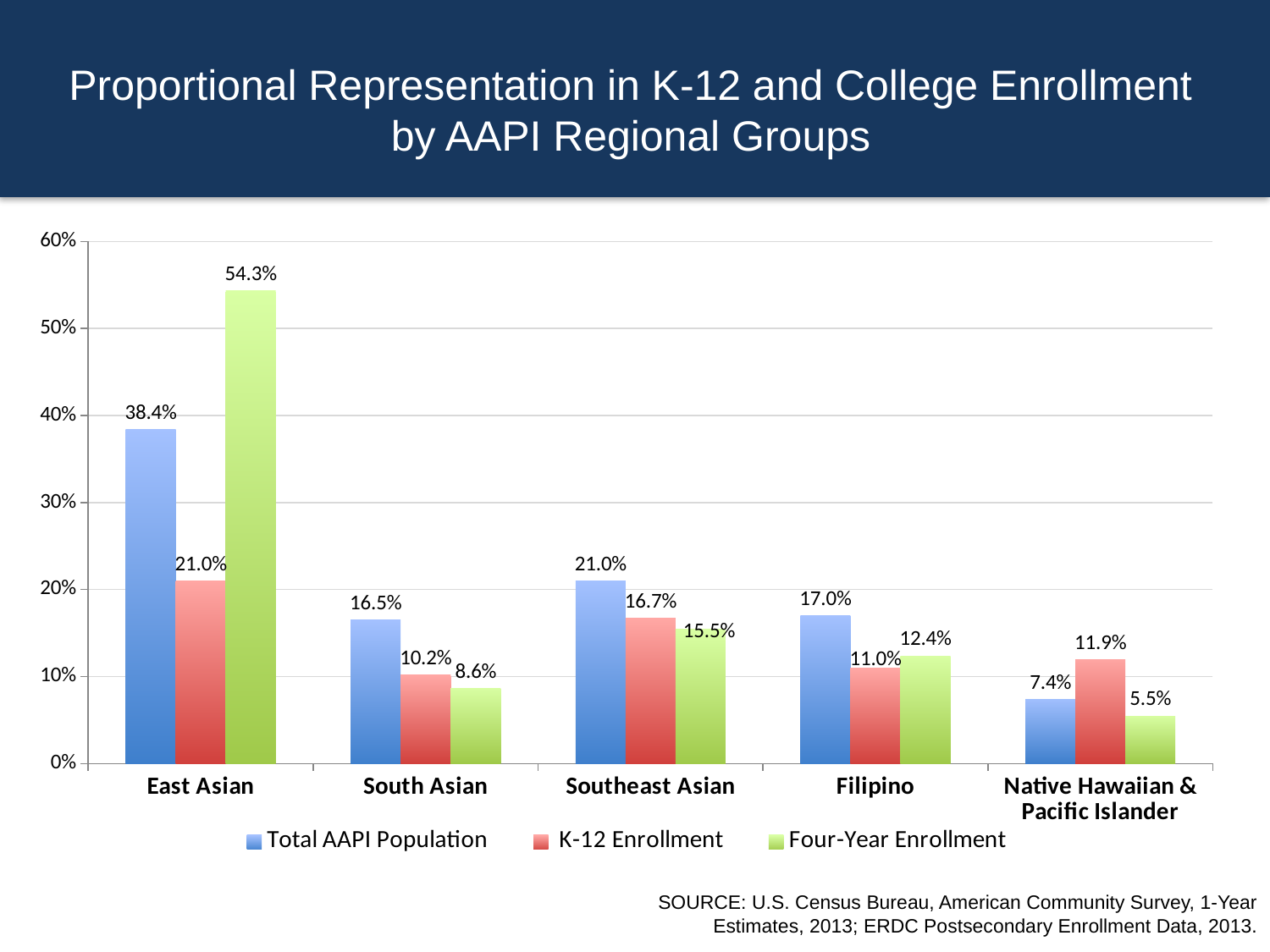
What is the Four-Year Enrollment value for East Asian? 54.3% What is the K-12 Enrollment value for South Asian? 10.2% What colour represents K-12 Enrollment in the legend? Red Which regional group has the lowest Four-Year Enrollment value? Native Hawaiian & Pacific Islander What is the difference between the Four-Year Enrollment and Total AAPI Population values for East Asian? 15.9% Which is larger for Filipino: the K-12 Enrollment value or the Four-Year Enrollment value? Four-Year Enrollment What kind of chart is shown on the slide? Bar chart Is the Total AAPI Population value for Southeast Asian greater or less than 20%? greater Which regional group has the highest Total AAPI Population value? East Asian How many series does the legend list? 3 What is the Total AAPI Population value for Native Hawaiian & Pacific Islander? 7.4% How many regional groups are shown on the x axis? 5